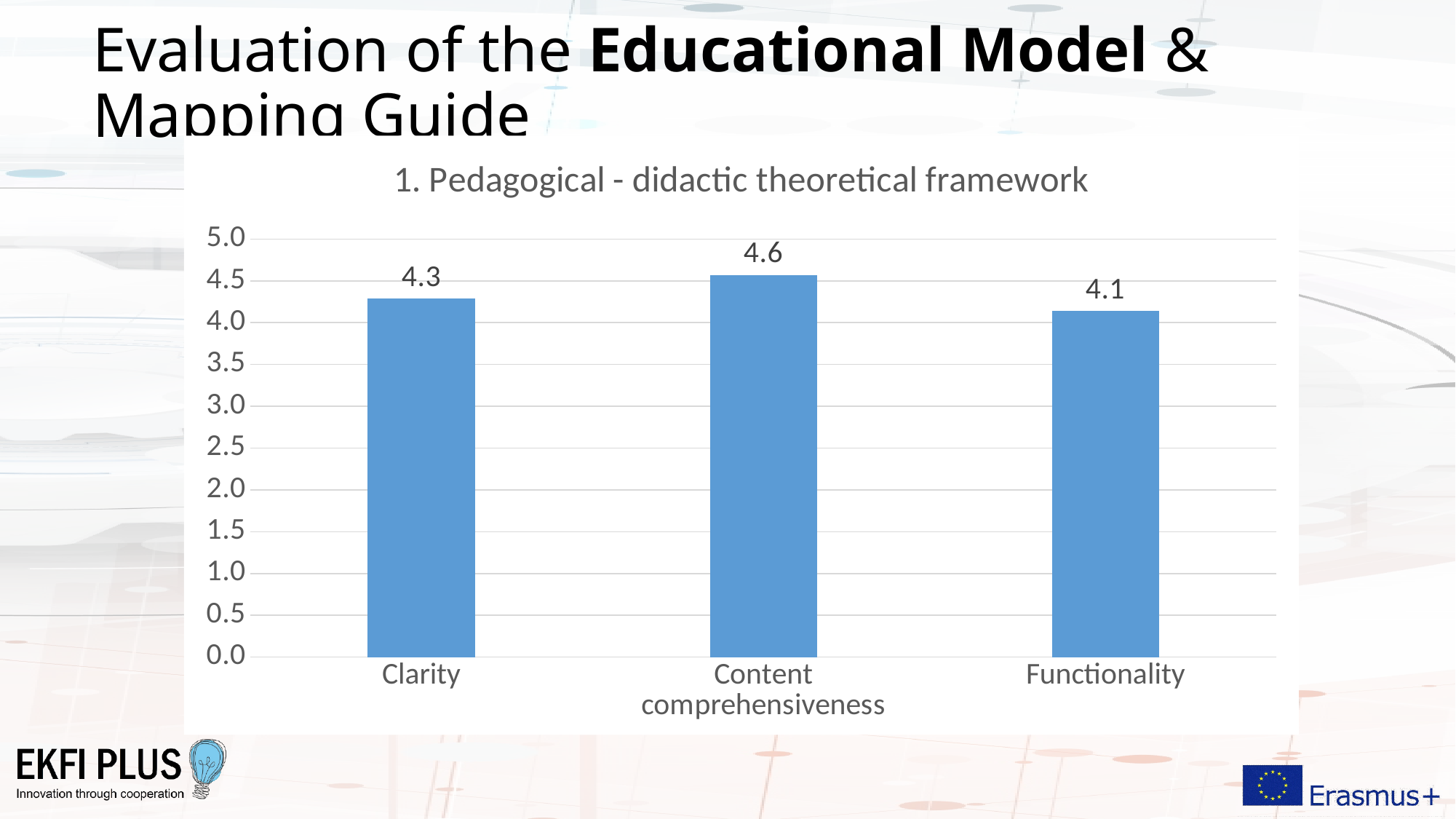
What is the title of the chart? 1. Pedagogical - didactic theoretical framework What is the value for Content comprehensiveness? 4.6 What kind of chart is shown on the slide? bar chart Is the value for Functionality greater or less than 4.0? greater Which is larger, the value for Clarity or the value for Content comprehensiveness? Content comprehensiveness Which category has the lowest value? Functionality What is the difference between the values for Content comprehensiveness and Functionality? 0.5 What is the value for Functionality? 4.1 What is the difference between the values for Clarity and Functionality? 0.2 How many categories are shown in the chart? 3 Which category has the highest value? Content comprehensiveness What is the value for Clarity? 4.3